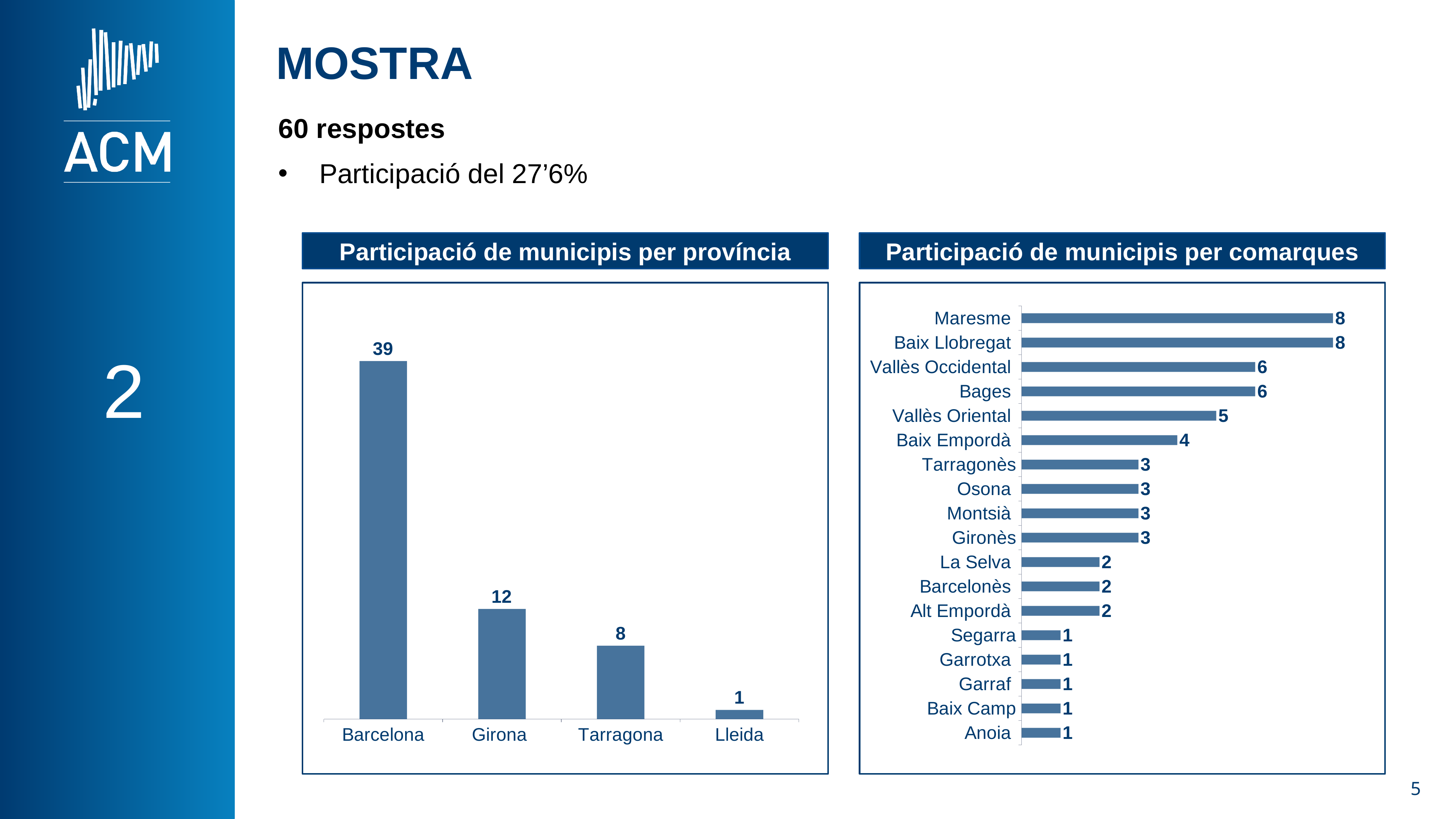
In the 'Participació de municipis per província' chart, what is the value for Barcelona? 39 In the 'Participació de municipis per província' chart, what is the difference between Barcelona and Tarragona? 31 In the 'Participació de municipis per comarques' chart, what is the value for Vallès Oriental? 5 In the 'Participació de municipis per província' chart, do the values rise or fall from Barcelona to Lleida? Fall What kind of chart is 'Participació de municipis per província'? Bar chart In the 'Participació de municipis per província' chart, what is the value for Girona? 12 In the 'Participació de municipis per comarques' chart, what is the value for Baix Empordà? 4 In the 'Participació de municipis per comarques' chart, what is the difference between Maresme and La Selva? 6 In the 'Participació de municipis per comarques' chart, which is larger, Bages or Tarragonès? Bages In the 'Participació de municipis per província' chart, how many provinces are shown? 4 In the 'Participació de municipis per comarques' chart, how many comarques are listed? 18 In the 'Participació de municipis per província' chart, which province has the lowest value? Lleida